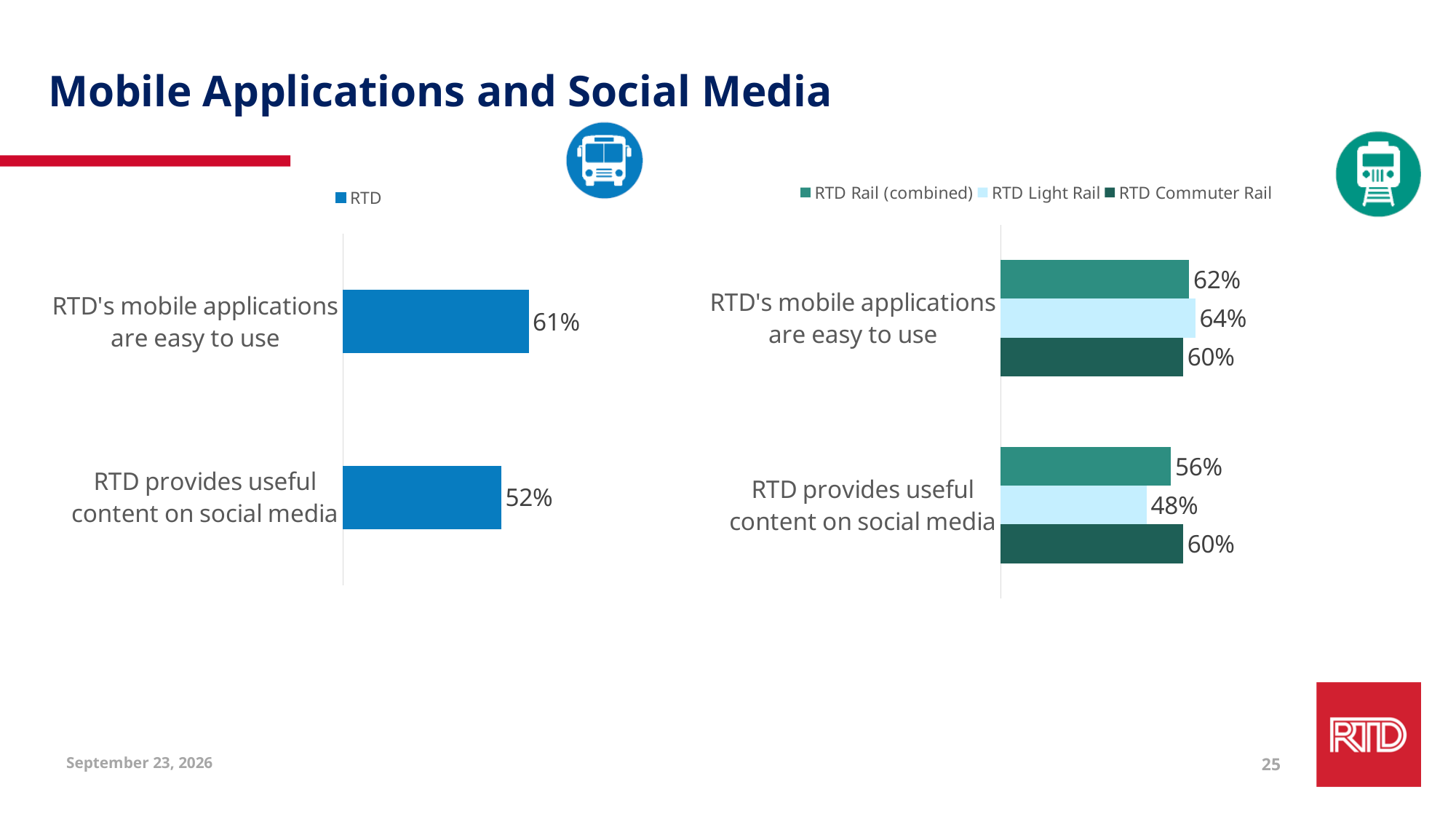
In the left chart (bus), what is the value for "RTD provides useful content on social media"? 52% In the right chart (rail), what is the RTD Light Rail value for "RTD's mobile applications are easy to use"? 64% In the left chart (bus), what is the value for "RTD's mobile applications are easy to use"? 61% In the right chart (rail), what is the difference between the RTD Light Rail values for the two statements? 16% In the right chart (rail), which is larger for "RTD provides useful content on social media": RTD Light Rail or RTD Commuter Rail? RTD Commuter Rail In the right chart (rail), which series has the lowest value for "RTD provides useful content on social media"? RTD Light Rail How many series does the legend of the right chart (rail) list? 3 In the left chart (bus), what is the difference between the two bars? 9% In the right chart (rail), which series has the highest value for "RTD's mobile applications are easy to use"? RTD Light Rail What kind of chart is the left chart (bus)? Bar chart In the right chart (rail), what is the RTD Rail (combined) value for "RTD provides useful content on social media"? 56% In the right chart (rail), what is the RTD Commuter Rail value for "RTD provides useful content on social media"? 60%